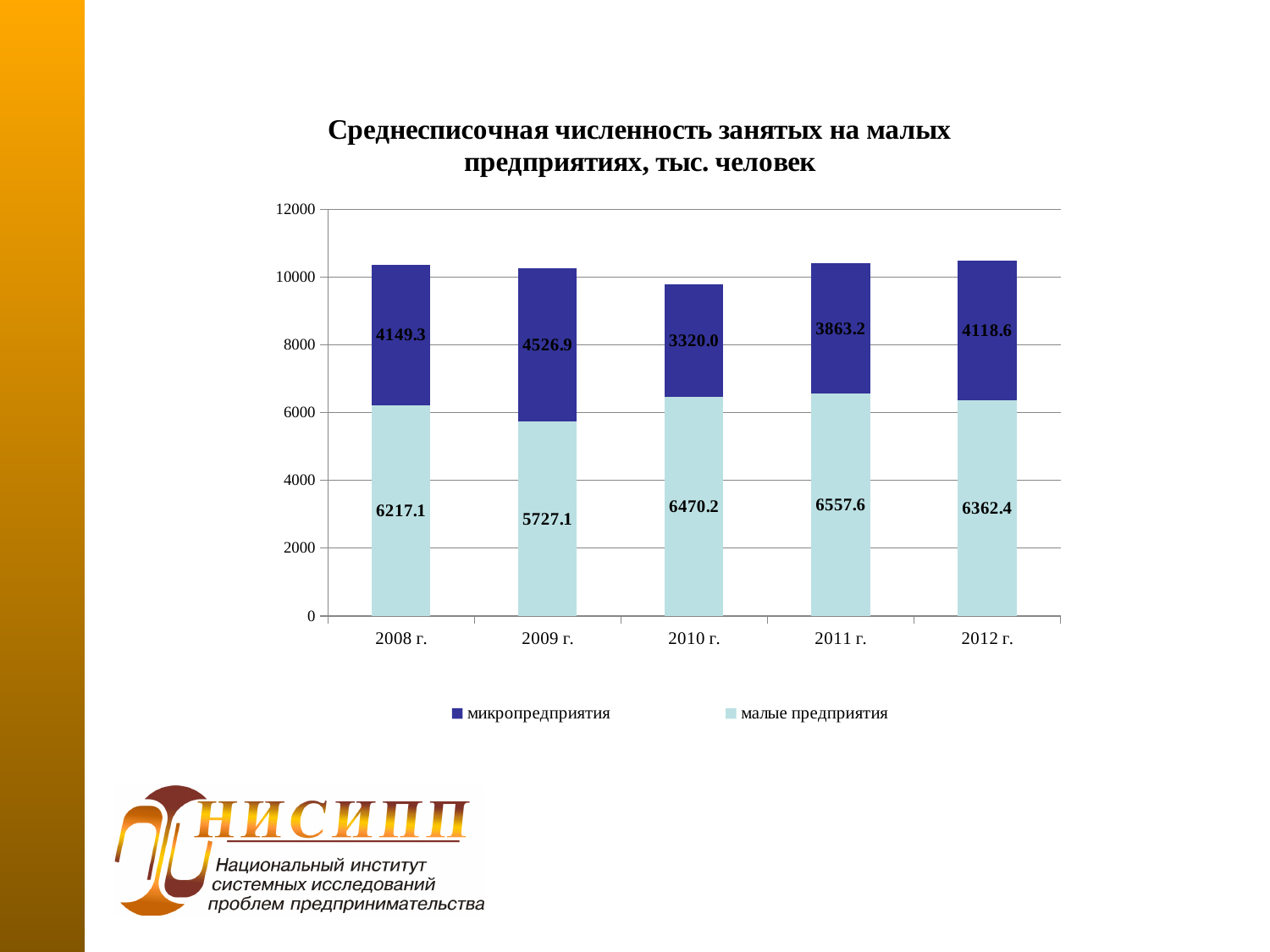
What is the value for микропредприятия in 2009 г.? 4526.9 In which year is the value for микропредприятия the highest? 2009 г. What is the value for микропредприятия in 2012 г.? 4118.6 In which year is the value for малые предприятия the lowest? 2009 г. In which year is the value for микропредприятия the lowest? 2010 г. How many series does the legend list? 2 What is the difference between the малые предприятия values for 2010 г. and 2009 г.? 743.1 What is the value for малые предприятия in 2011 г.? 6557.6 What is the total of the stacked bar for 2010 г.? 9790.2 Is the total height of the bar for 2012 г. greater or less than 10000? greater How many years are shown on the x axis? 5 Which is larger: the микропредприятия value in 2008 г. or in 2011 г.? 2008 г.